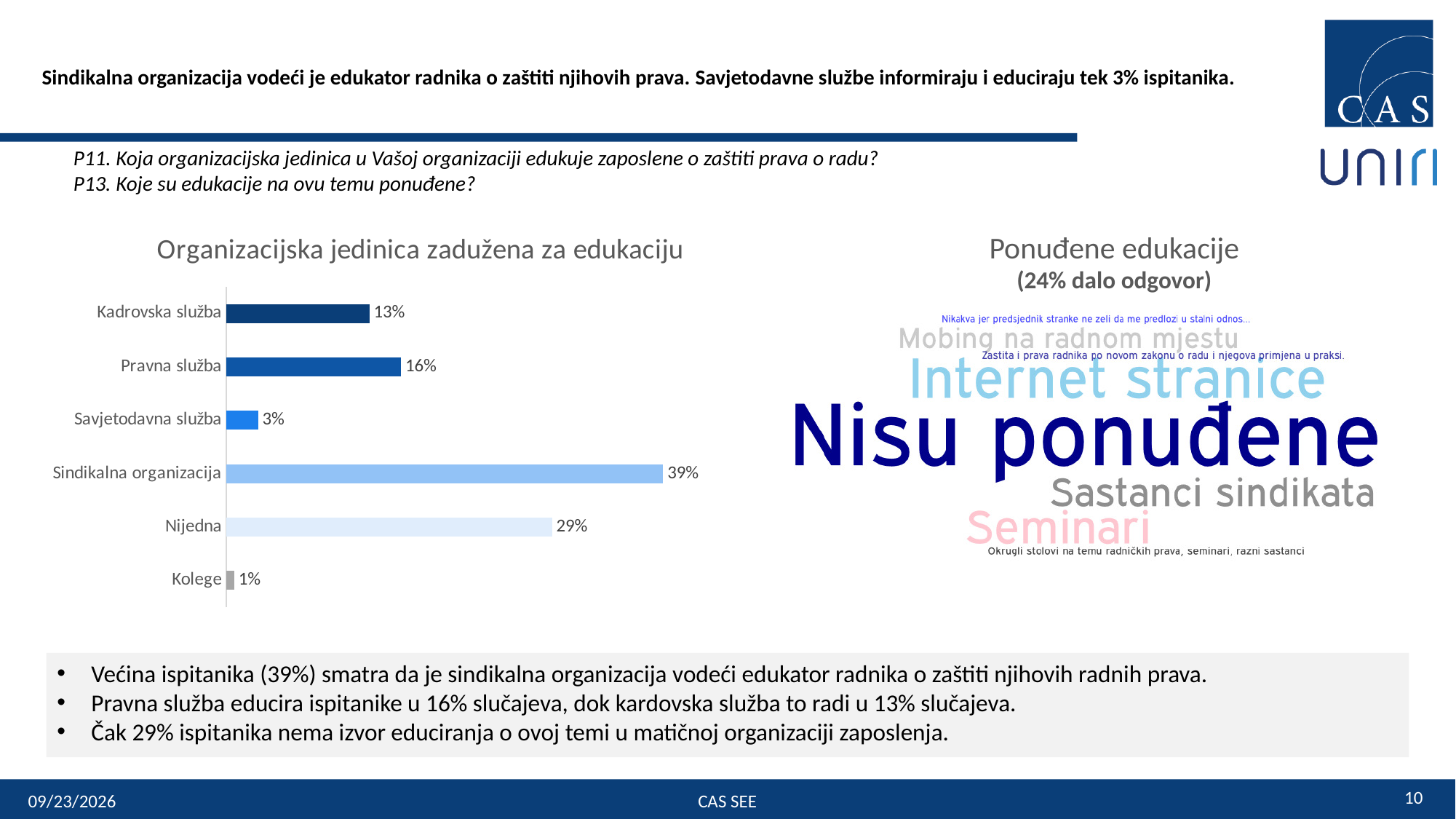
What is the title of the bar chart on the left side of the slide? Organizacijska jedinica zadužena za edukaciju In the chart "Organizacijska jedinica zadužena za edukaciju", what is the value for Savjetodavna služba? 3% In the chart "Organizacijska jedinica zadužena za edukaciju", which category has the lowest value? Kolege What kind of chart is "Organizacijska jedinica zadužena za edukaciju"? Bar chart In the chart "Organizacijska jedinica zadužena za edukaciju", which category has the highest value? Sindikalna organizacija In the chart "Organizacijska jedinica zadužena za edukaciju", what is the value for Pravna služba? 16% In the chart "Organizacijska jedinica zadužena za edukaciju", what is the difference between the values for Sindikalna organizacija and Nijedna? 10% In the chart "Organizacijska jedinica zadužena za edukaciju", what is the value for Kolege? 1% How many categories are shown in the chart "Organizacijska jedinica zadužena za edukaciju"? 6 In the chart "Organizacijska jedinica zadužena za edukaciju", what is the difference between the values for Pravna služba and Kadrovska služba? 3% In the chart "Organizacijska jedinica zadužena za edukaciju", which is larger: the value for Kadrovska služba or the value for Pravna služba? Pravna služba In the chart "Organizacijska jedinica zadužena za edukaciju", what is the value for Sindikalna organizacija? 39%